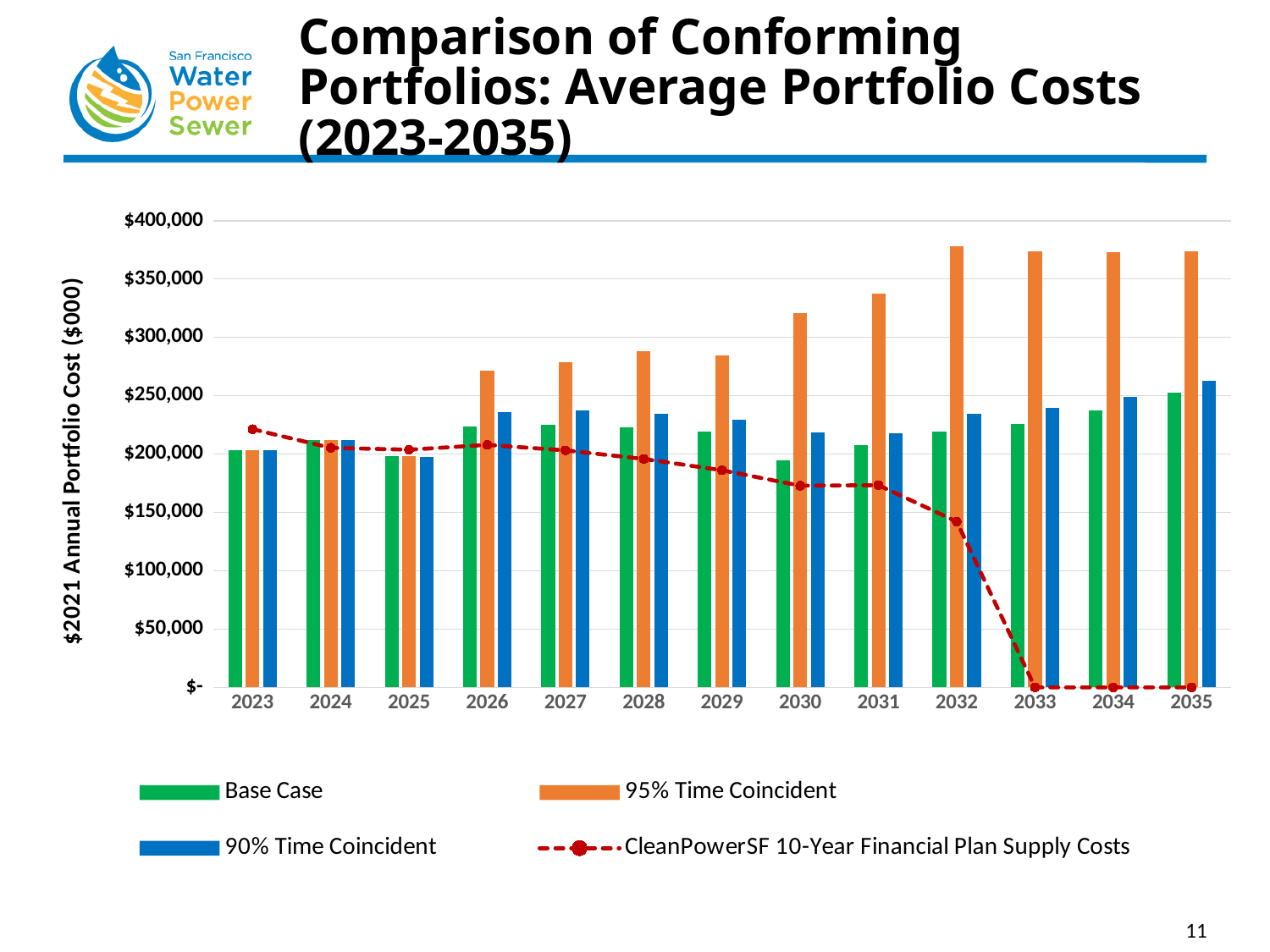
In 2035, which is larger: the Base Case bar or the 90% Time Coincident bar? 90% Time Coincident In 2030, which is larger: the 95% Time Coincident bar or the 90% Time Coincident bar? 95% Time Coincident How many years are shown on the x axis of the chart? 13 Is the value for 95% Time Coincident in 2032 greater or less than $350,000? greater How many series does the chart's legend list? 4 What is the title of the chart's vertical axis? $2021 Annual Portfolio Cost ($000) Is the value for 90% Time Coincident in 2035 greater or less than $250,000? greater Is the value for 95% Time Coincident in 2030 greater or less than $300,000? greater What kind of chart is shown on the slide? Bar chart with a line series Does the CleanPowerSF 10-Year Financial Plan Supply Costs line generally rise or fall from 2023 to 2035? fall In which year is the Base Case bar highest? 2035